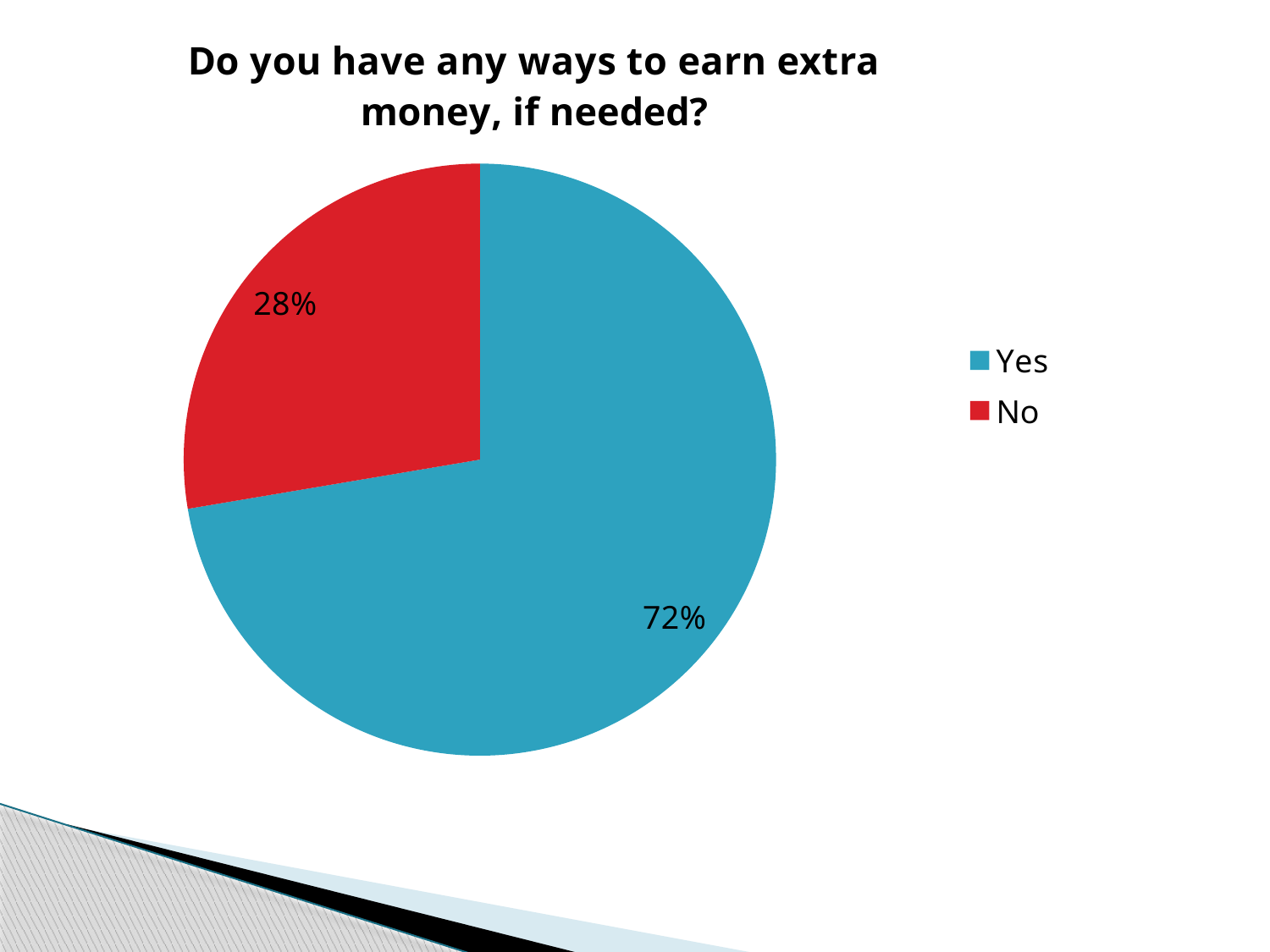
What percentage of respondents answered Yes? 72% How many entries does the legend list? 2 Which response has the smallest share of the pie? No What is the title of the chart? Do you have any ways to earn extra money, if needed? Which response has the largest share of the pie? Yes What share of the pie does the Yes slice represent? 72% How many slices does the pie chart have? 2 What type of chart is shown on the slide? pie chart What percentage of respondents answered No? 28% Which is larger, the share for Yes or the share for No? Yes What colour is the slice for No? red What is the difference in percentage points between the Yes and No shares? 44